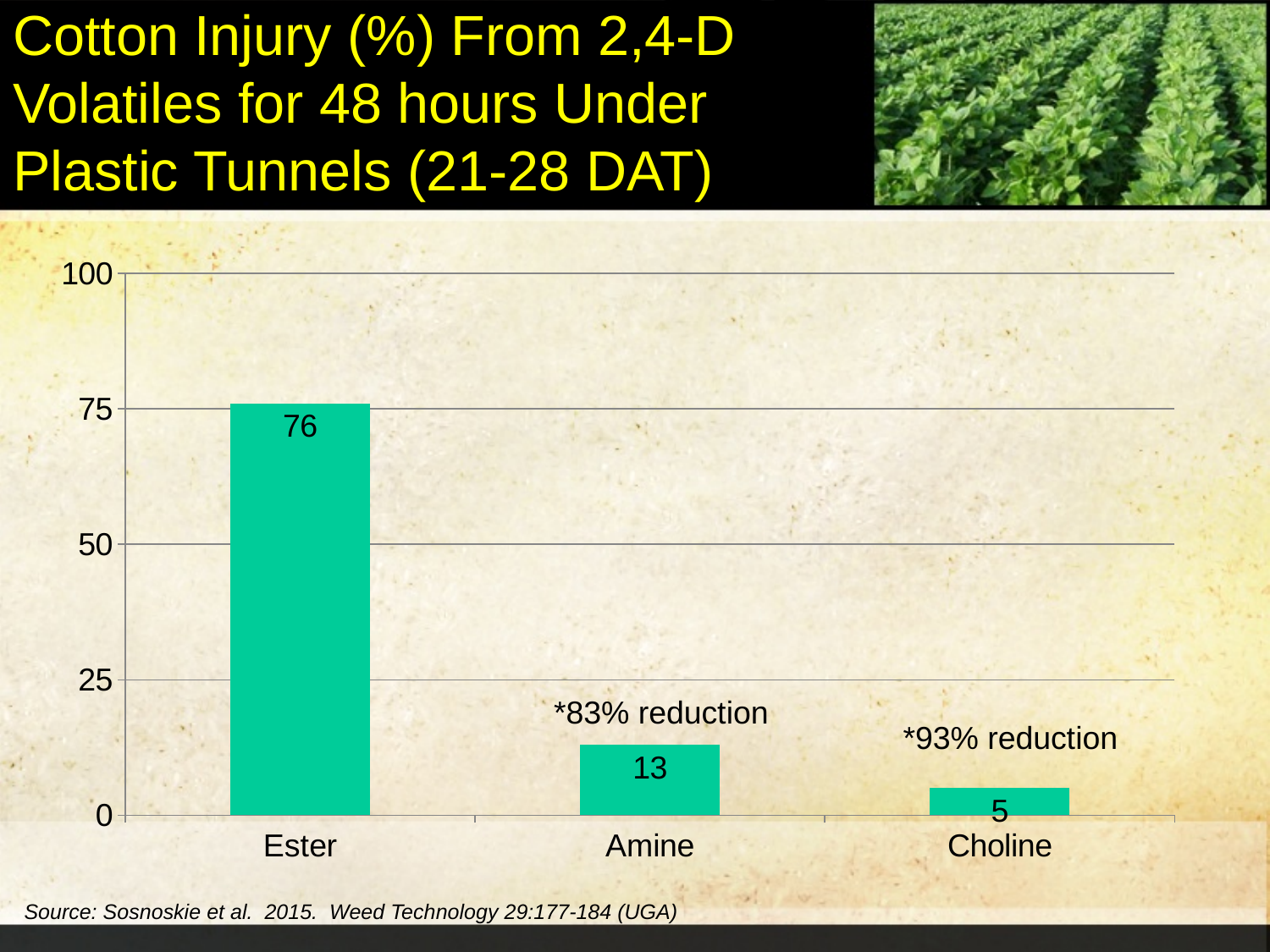
What is the cotton injury value for Ester? 76 How many categories are shown on the x axis? 3 Is the value for Ester greater or less than 50? greater What is the difference between the values for Ester and Amine? 63 Which has a larger value, Amine or Choline? Amine What kind of chart is shown on the slide? bar chart What is the difference between the values for Amine and Choline? 8 What is the cotton injury value for Choline? 5 What percent reduction is annotated above the Choline bar? 93% reduction What is the cotton injury value for Amine? 13 Which category has the highest cotton injury value? Ester Which category has the lowest cotton injury value? Choline